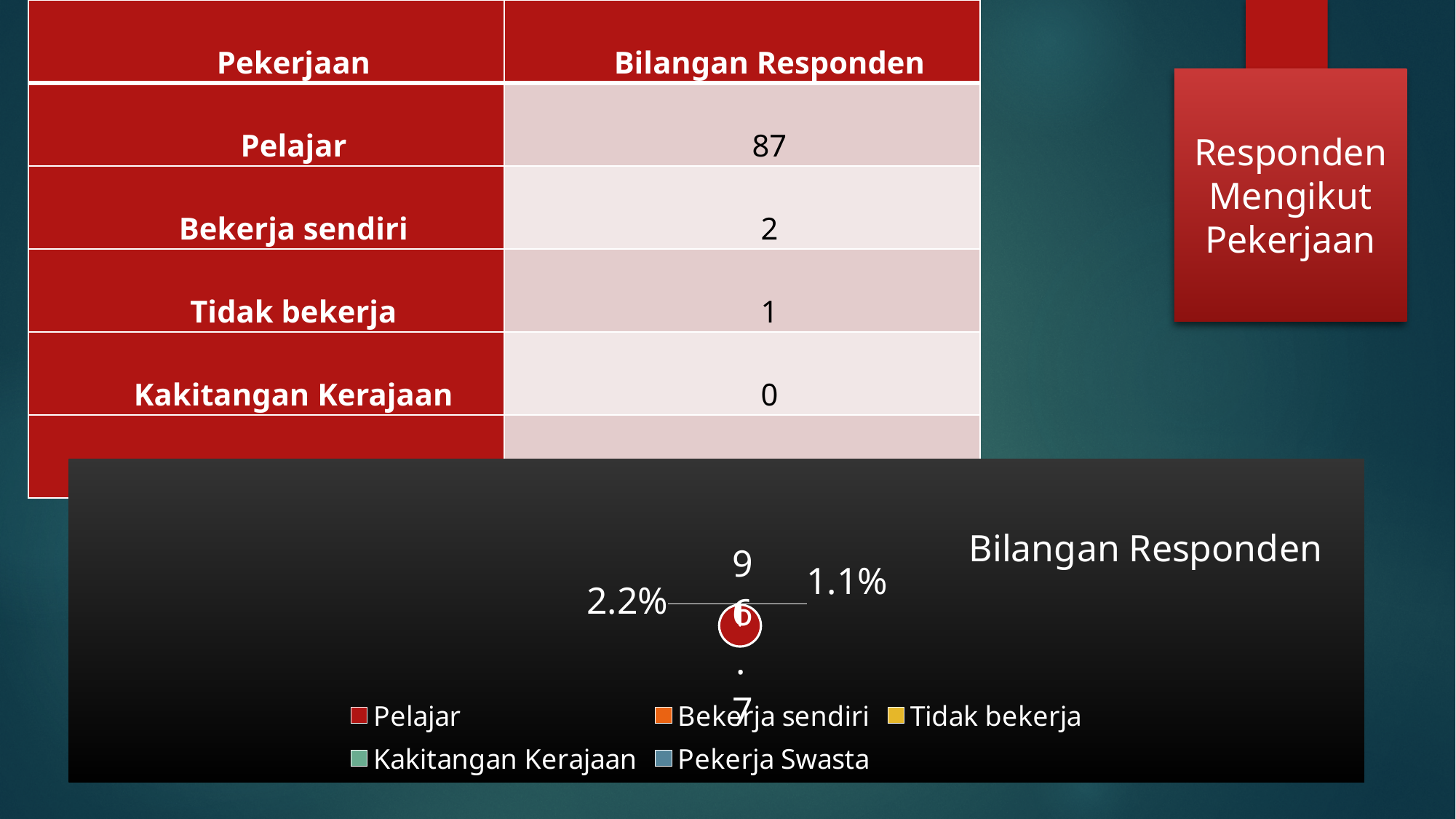
Which colour represents Pelajar in the pie chart legend? red Which category has the largest slice in the pie chart? Pelajar What kind of chart is shown at the bottom of the slide? pie chart What is the smallest percentage label printed on the pie chart? 1.1% Is the Pelajar slice of the pie chart greater or less than 50% of the pie? greater What is the title of the pie chart? Bilangan Responden Which category is listed last in the pie chart's legend? Pekerja Swasta How many categories does the pie chart's legend list? 5